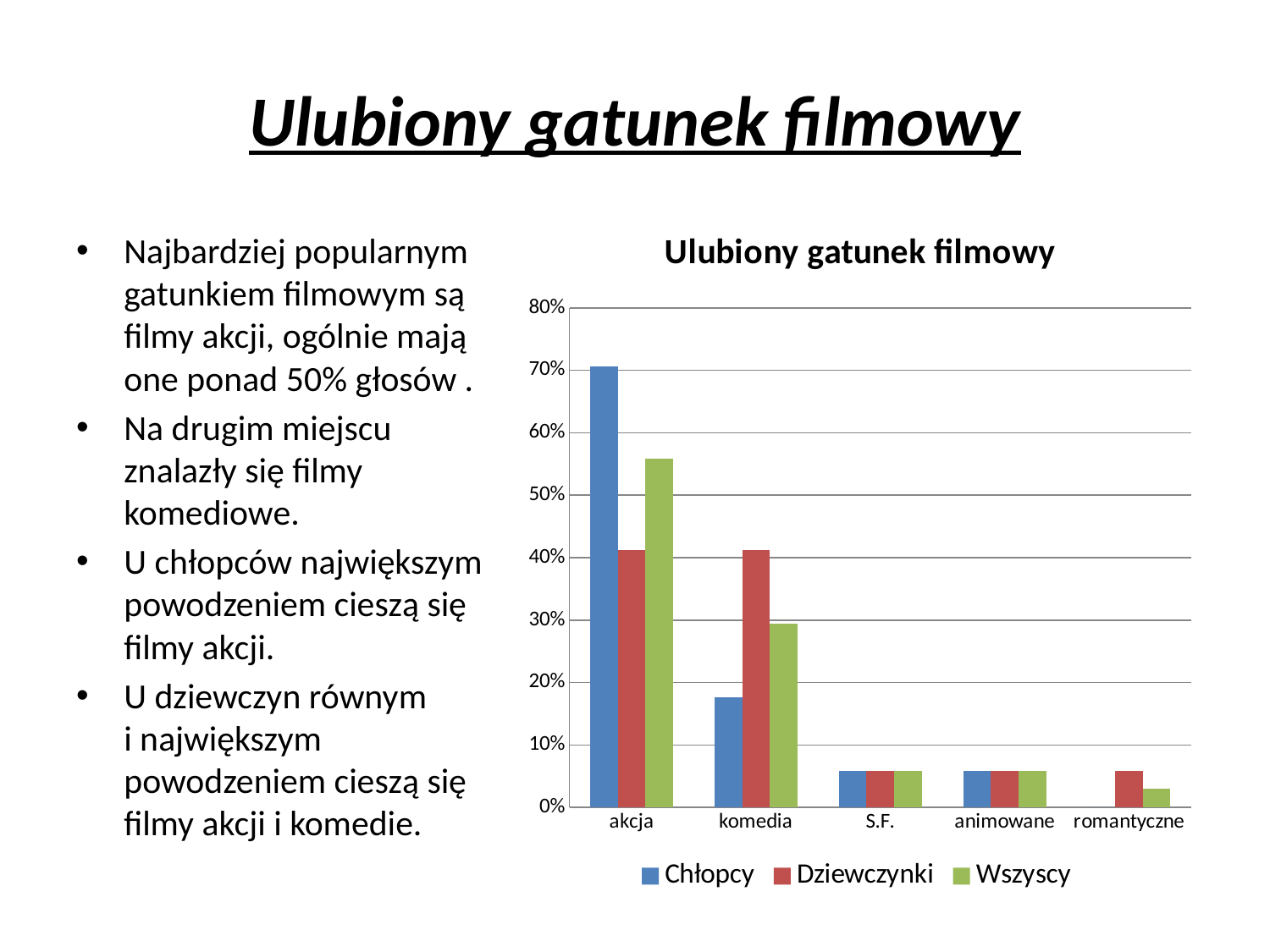
In komedia, which is larger: Chłopcy or Dziewczynki? Dziewczynki Is the value for Chłopcy in akcja greater or less than 60%? greater Which genre has the lowest value for Chłopcy? romantyczne What kind of chart is shown on the slide? bar chart Is the value for Wszyscy in akcja greater or less than 50%? greater Is the value for Chłopcy in komedia greater or less than 20%? less How many series does the legend list? 3 Which genre has the highest value for Chłopcy? akcja In akcja, which is larger: Chłopcy or Dziewczynki? Chłopcy What is the title of the chart? Ulubiony gatunek filmowy How many film genres are shown on the x axis? 5